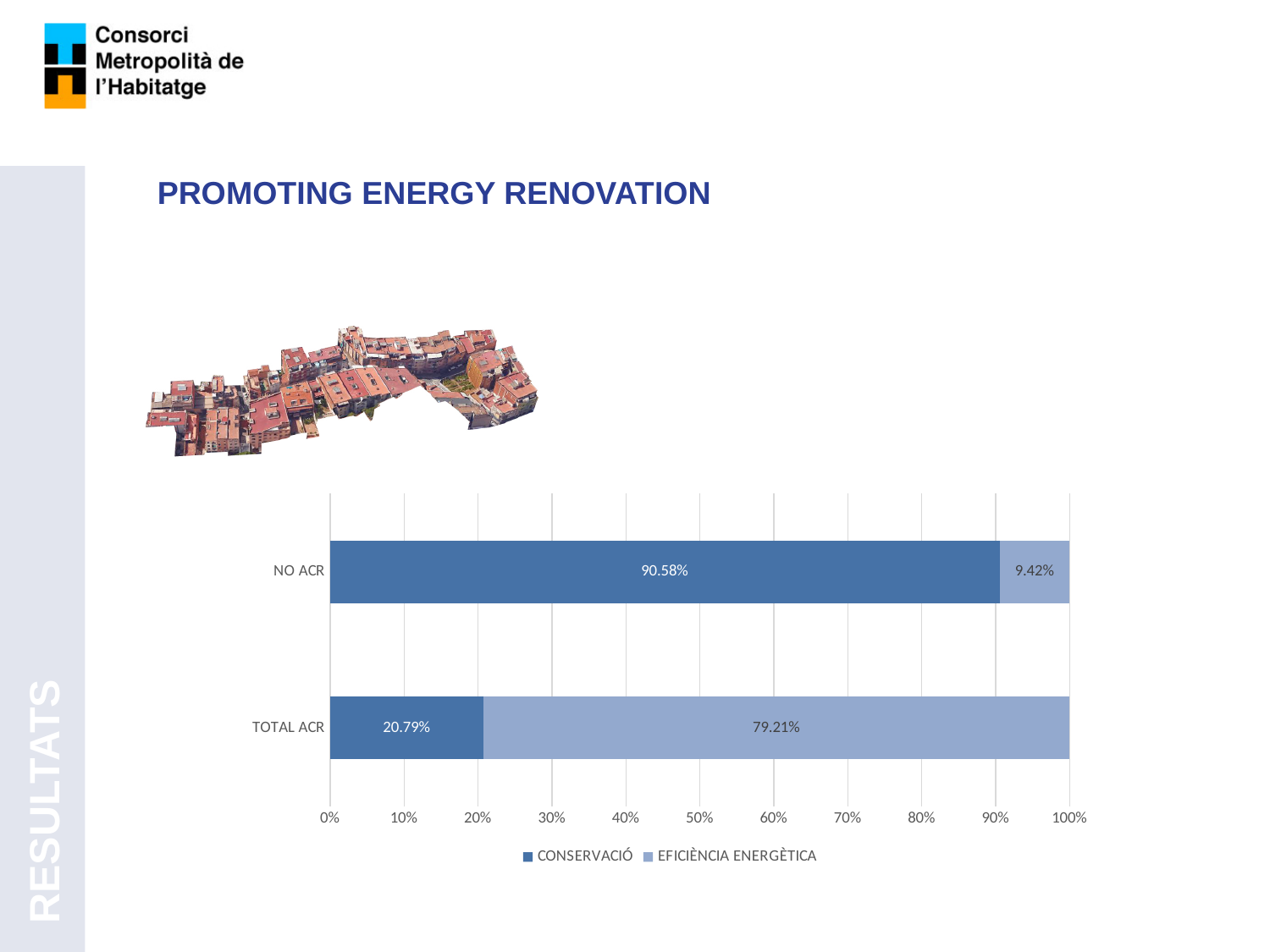
How many categories are shown on the chart? 2 What is the EFICIÈNCIA ENERGÈTICA value for TOTAL ACR? 79.21% What kind of chart is shown on the slide? Stacked bar chart What is the CONSERVACIÓ value for NO ACR? 90.58% What is the difference between the CONSERVACIÓ values for NO ACR and TOTAL ACR? 69.79% Which series is shown in the darker blue colour? CONSERVACIÓ How many series does the legend list? 2 What is the EFICIÈNCIA ENERGÈTICA value for NO ACR? 9.42% What is the total of the stacked bar for TOTAL ACR? 100% What is the CONSERVACIÓ value for TOTAL ACR? 20.79% Which category has the higher CONSERVACIÓ value, NO ACR or TOTAL ACR? NO ACR Which category has the lowest EFICIÈNCIA ENERGÈTICA value? NO ACR